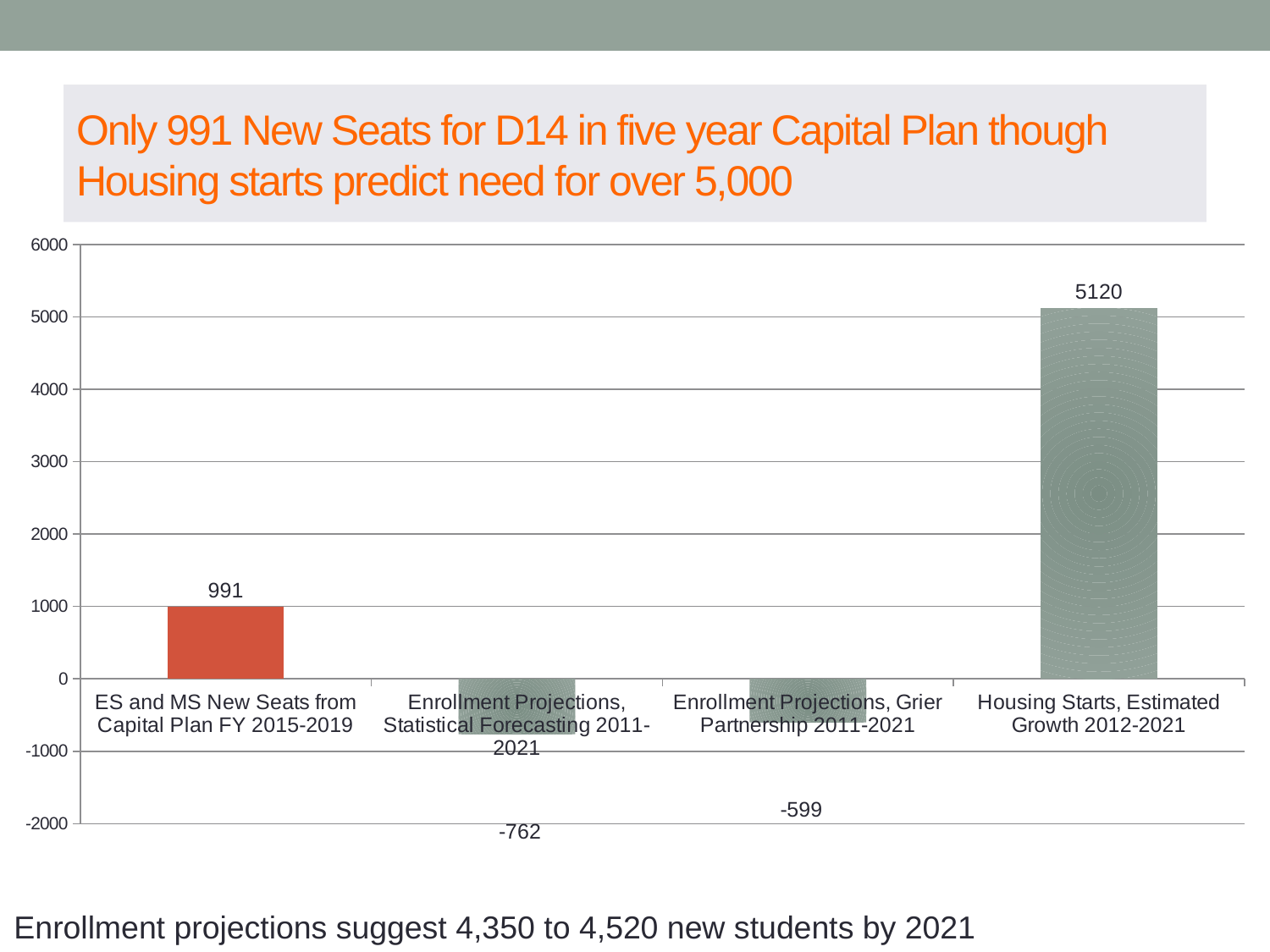
Which category has the highest value? Housing Starts, Estimated Growth 2012-2021 What is the value for ES and MS New Seats from Capital Plan FY 2015-2019? 991 Which category has the lowest value? Enrollment Projections, Statistical Forecasting 2011-2021 Is the value for Housing Starts, Estimated Growth 2012-2021 greater or less than 5000? greater How many categories are shown in the chart? 4 What is the value for Enrollment Projections, Statistical Forecasting 2011-2021? -762 What is the difference between the value for Housing Starts, Estimated Growth 2012-2021 and the value for ES and MS New Seats from Capital Plan FY 2015-2019? 4129 Which is larger: the value for Enrollment Projections, Grier Partnership 2011-2021 or the value for Enrollment Projections, Statistical Forecasting 2011-2021? Enrollment Projections, Grier Partnership 2011-2021 What is the value for Enrollment Projections, Grier Partnership 2011-2021? -599 How many of the bars have negative values? 2 What is the value for Housing Starts, Estimated Growth 2012-2021? 5120 What kind of chart is shown on the slide? bar chart